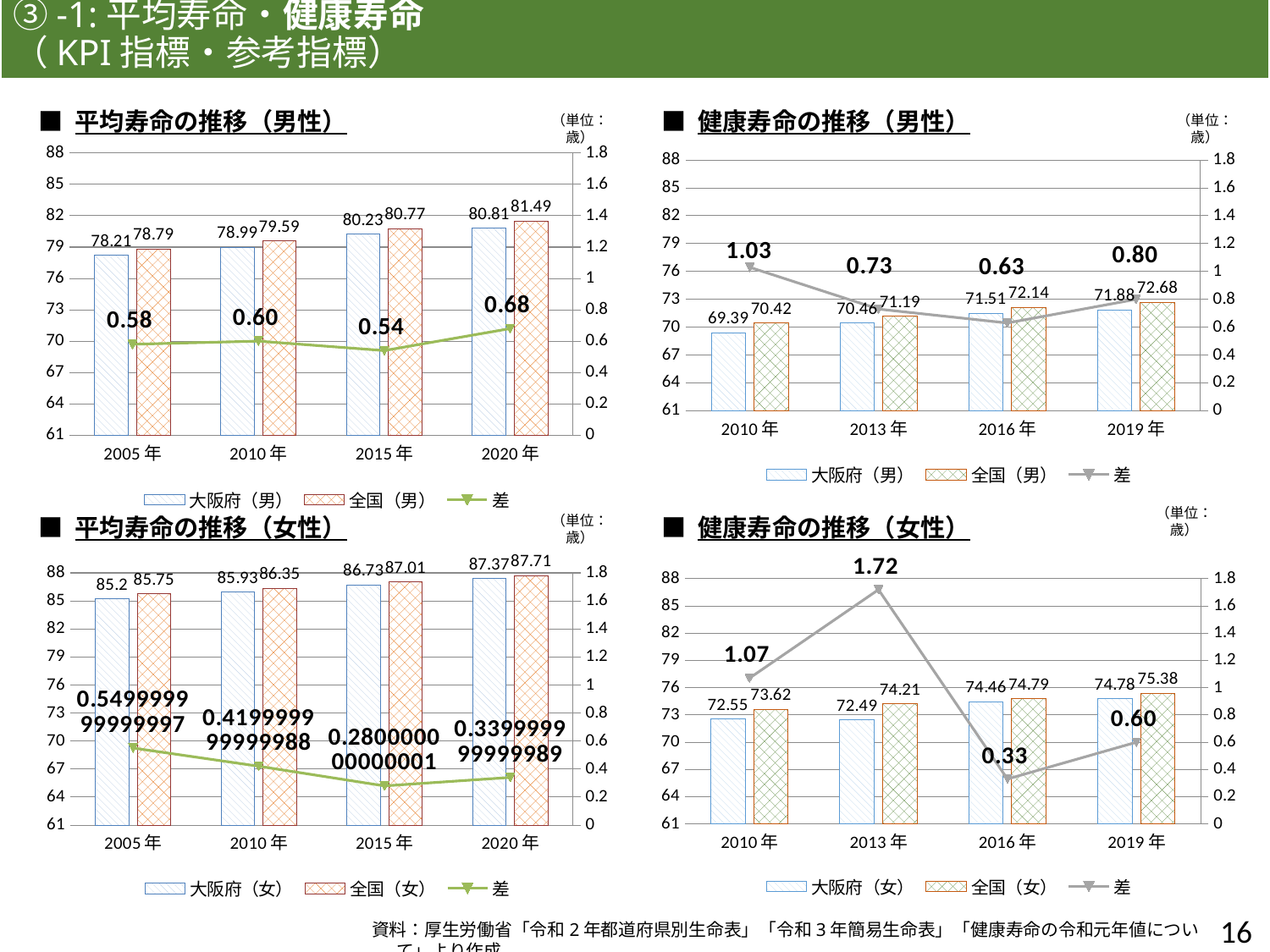
How many years are shown on the x axis of the 健康寿命の推移（男性） chart? 4 In the 平均寿命の推移（女性） chart, what is the value for 全国（女） in 2020年? 87.71 In the 健康寿命の推移（男性） chart, what is the difference between 全国（男） and 大阪府（男） in 2019年? 0.80 In the 健康寿命の推移（男性） chart, what is the value for 全国（男） in 2016年? 72.14 In the 健康寿命の推移（女性） chart, what is the 差 value for 2013年? 1.72 In the 平均寿命の推移（男性） chart, in which year is the 差 value lowest? 2015年 In the 健康寿命の推移（男性） chart, in which year is the 差 value highest? 2010年 How many series does the legend of the 健康寿命の推移（女性） chart list? 3 In the 平均寿命の推移（女性） chart, does the value for 大阪府（女） rise or fall from 2005年 to 2020年? rise In the 健康寿命の推移（女性） chart, which is larger in 2016年, 大阪府（女） or 全国（女）? 全国（女） In the 平均寿命の推移（男性） chart, what is the value for 大阪府（男） in 2005年? 78.21 In the 平均寿命の推移（男性） chart, what is the 差 value for 2020年? 0.68